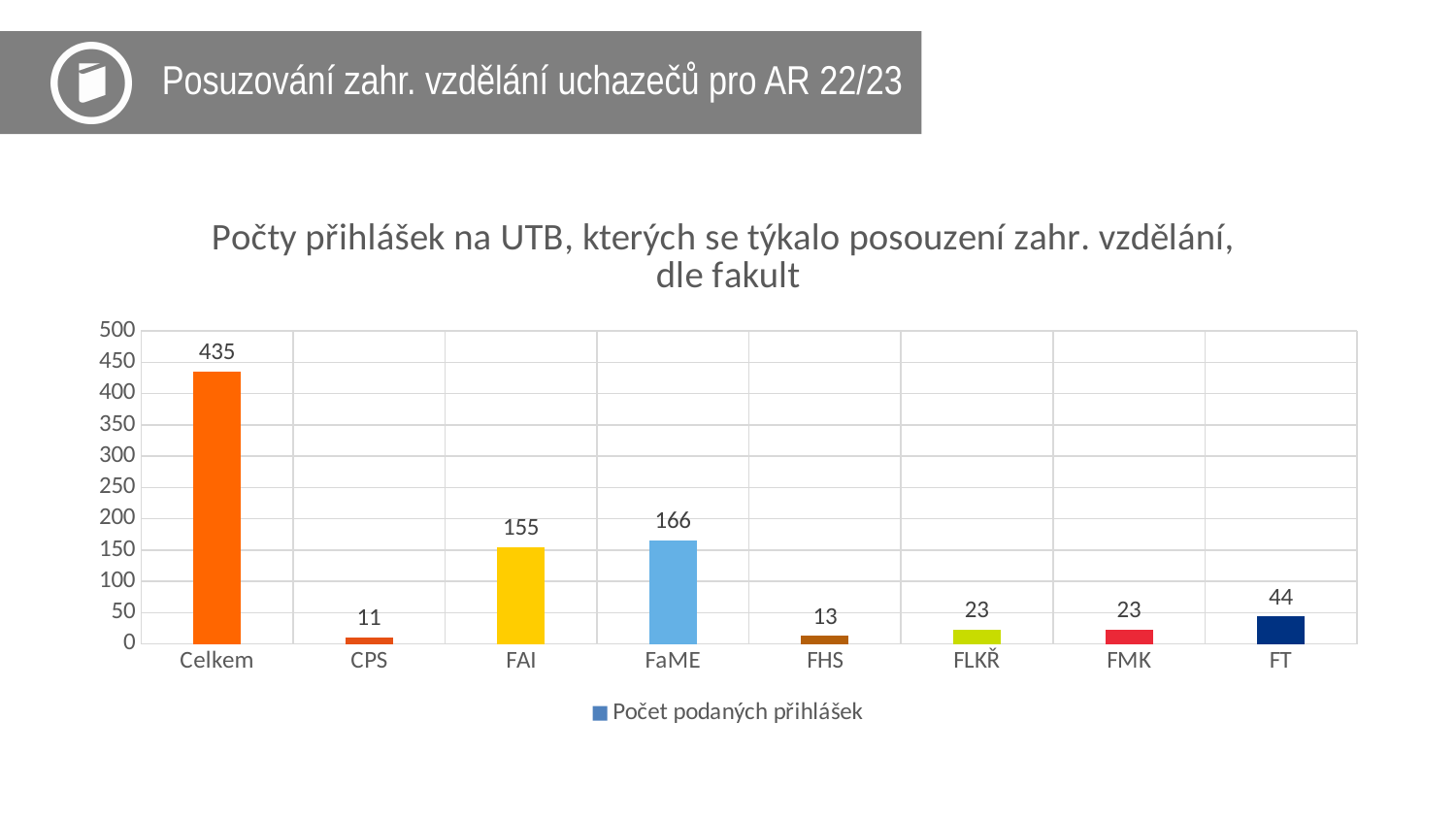
What kind of chart is shown? bar chart What is the difference between the values for FaME and FAI? 11 How many series does the legend list? 1 How many categories are shown on the x axis? 8 Which category has the highest value? Celkem What is the value for FaME? 166 What is the value for CPS? 11 Which category has the lowest value? CPS What is the value for FT? 44 Is the value for Celkem greater or less than 400? greater Which is larger, the value for FT or the value for FHS? FT What is the legend entry of the chart? Počet podaných přihlášek